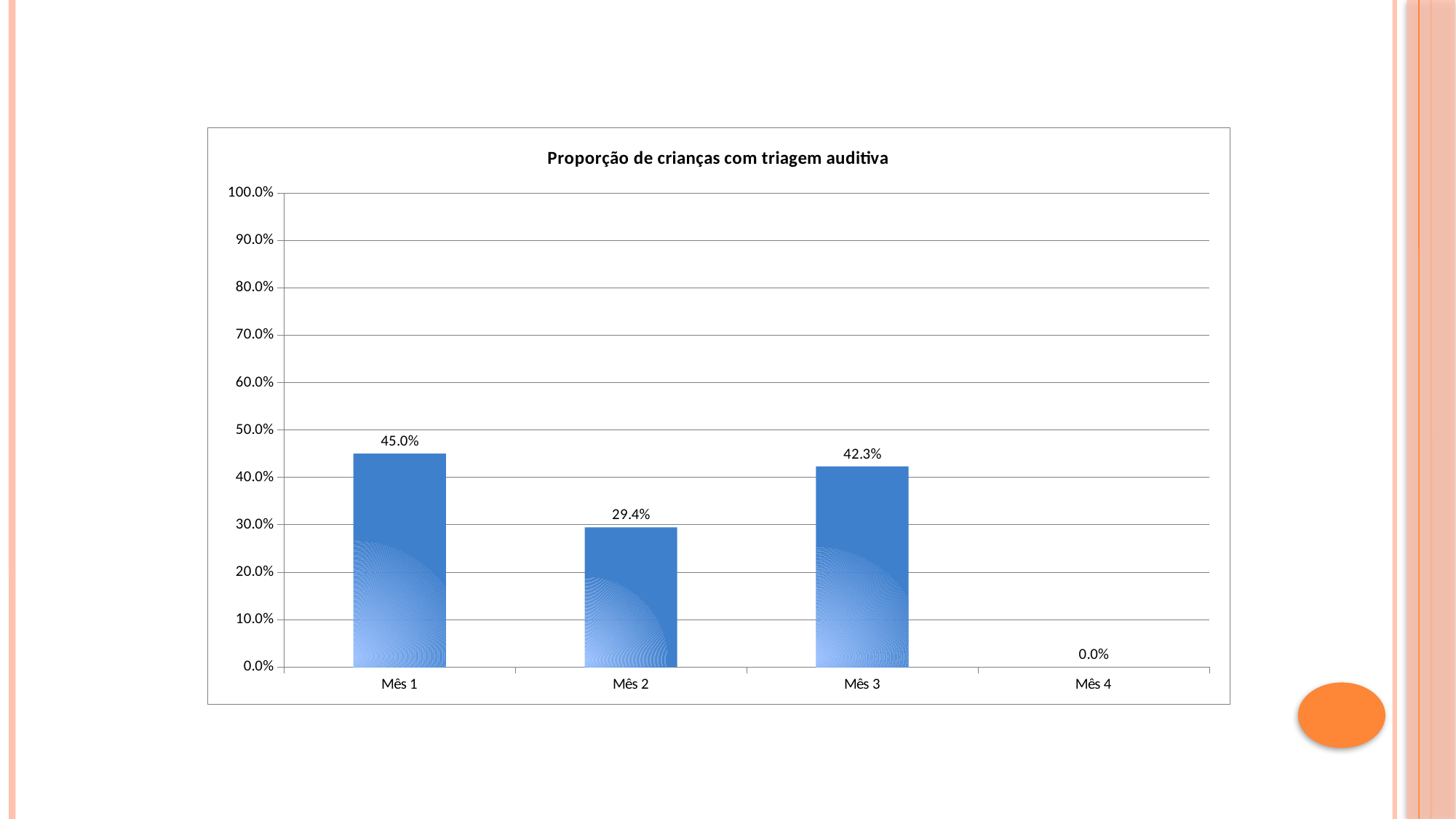
Which month has the lowest proportion? Mês 4 What is the difference between the values for Mês 1 and Mês 2? 15.6% What is the value for Mês 1? 45.0% What is the value for Mês 2? 29.4% What is the value for Mês 4? 0.0% What is the value for Mês 3? 42.3% How many months are shown on the x axis? 4 Which is larger, the value for Mês 2 or the value for Mês 3? Mês 3 What is the title of the chart? Proporção de crianças com triagem auditiva What kind of chart is shown on the slide? bar chart Is the value for Mês 3 greater or less than 50.0%? less Which month has the highest proportion? Mês 1